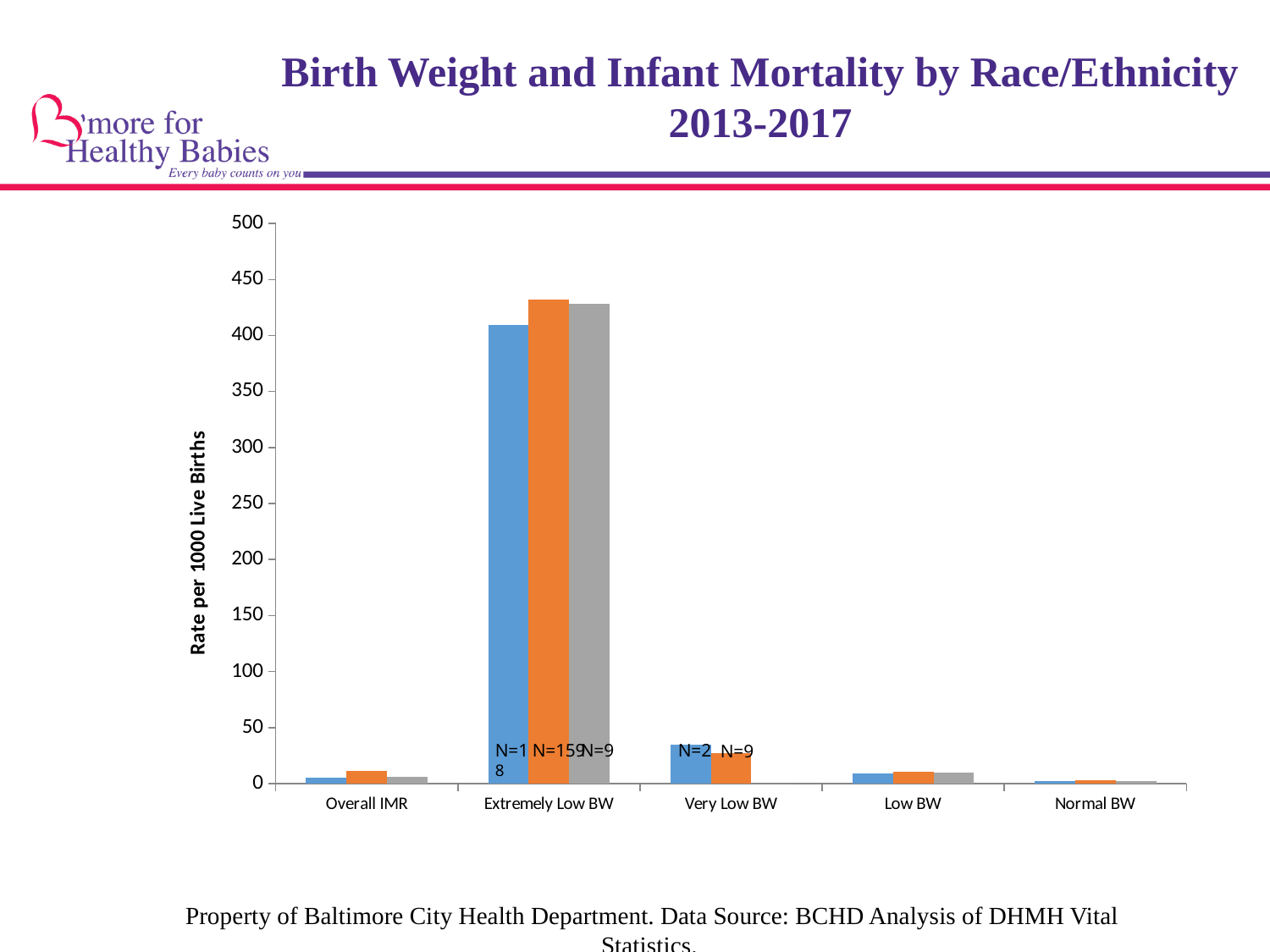
Is the value of the orange bar for Extremely Low BW greater or less than 450? less What is the label on the y axis of the chart? Rate per 1000 Live Births What kind of chart is shown on the slide? Bar chart Is the value of the blue bar for Extremely Low BW greater or less than 400? greater How many birth weight categories are shown along the x axis? 5 Within Extremely Low BW, which is larger: the blue bar or the orange bar? The orange bar Is the value of the orange bar for Overall IMR greater or less than 50? less Which category has the highest bars? Extremely Low BW What is the title of the slide's chart? Birth Weight and Infant Mortality by Race/Ethnicity 2013-2017 Which is larger: the blue bar for Extremely Low BW or the blue bar for Very Low BW? Extremely Low BW Which category has the shortest bars? Normal BW